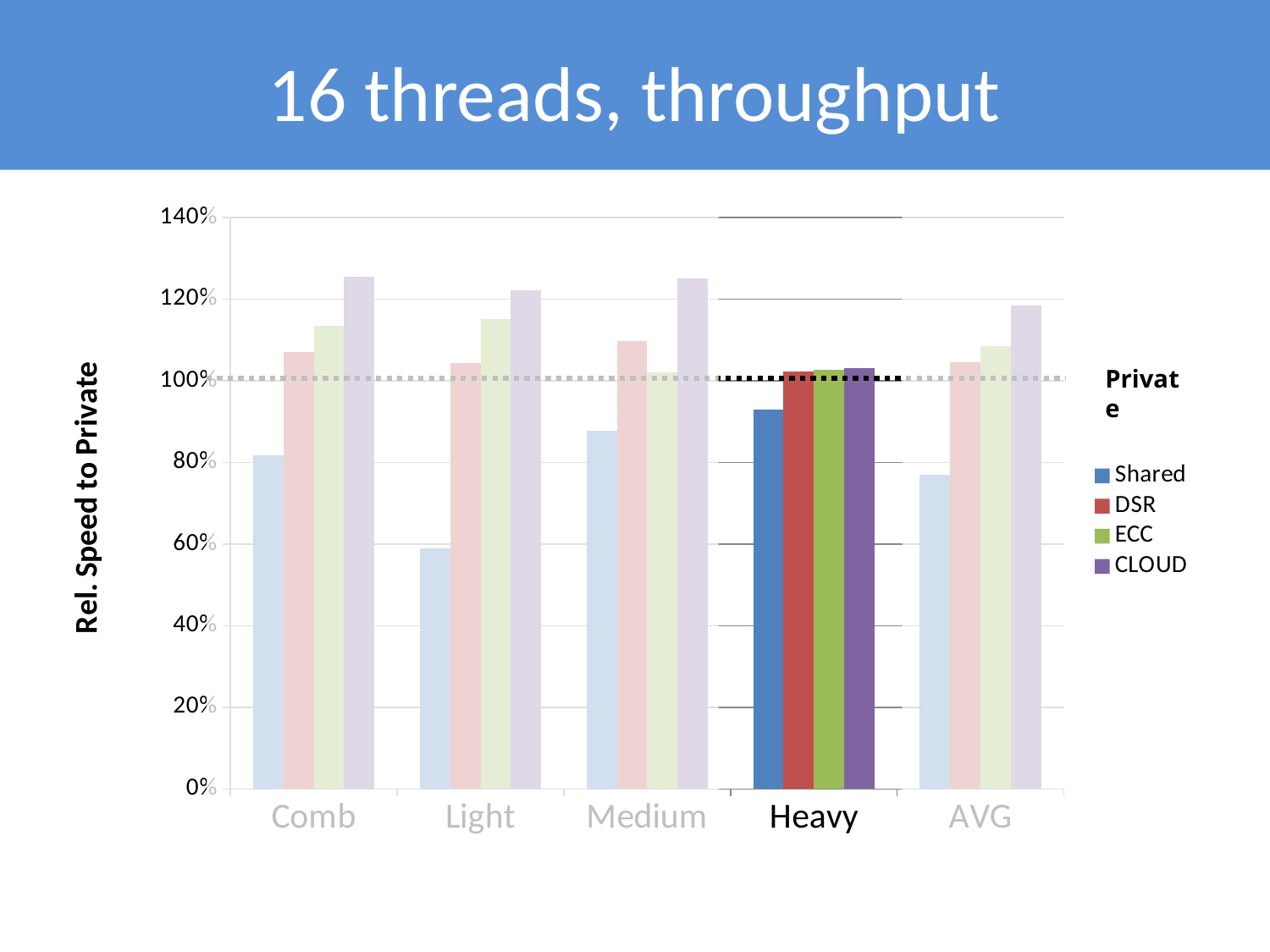
What kind of chart is shown on the slide? bar chart Is the Shared value for Light greater or less than 80%? less How many categories are shown on the x axis? 5 Is the Shared value for Heavy greater or less than 100%? less Is the DSR value for Medium greater or less than 100%? greater How many bar series does the legend list? 4 What is the title of the y axis? Rel. Speed to Private Which series has the highest bar in the Comb category? CLOUD Which category has the lowest Shared bar? Light Which category is highlighted on the chart while the others are faded? Heavy Which is larger, the Shared value for Light or the Shared value for Heavy? Heavy